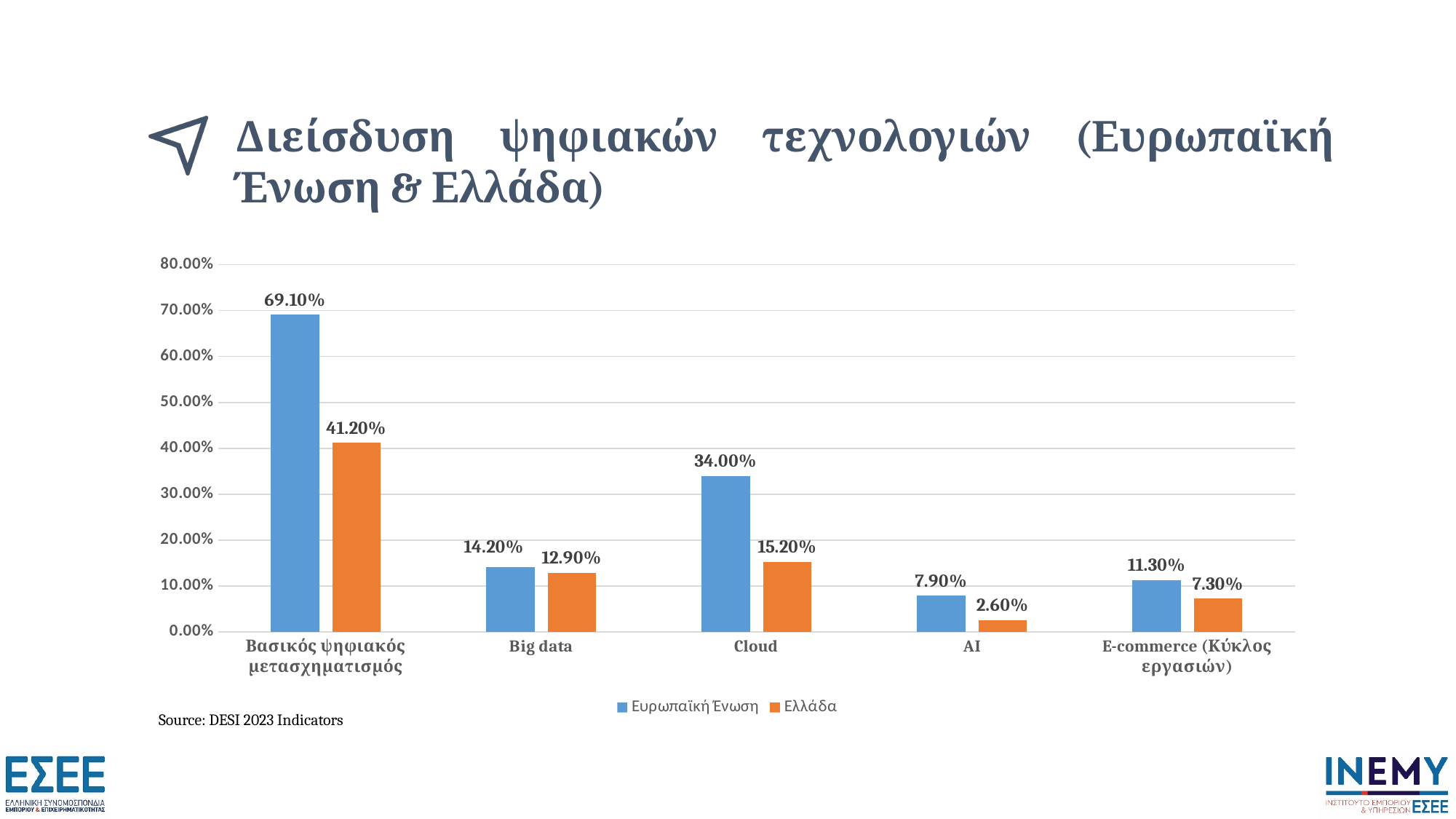
What is the difference between the Ευρωπαϊκή Ένωση and Ελλάδα values in the Βασικός ψηφιακός μετασχηματισμός category? 27.90% What is the value for Ελλάδα in the AI category? 2.60% Is the Ευρωπαϊκή Ένωση value for E-commerce (Κύκλος εργασιών) greater or less than 10.00%? greater Which is larger in the Cloud category, the Ευρωπαϊκή Ένωση value or the Ελλάδα value? Ευρωπαϊκή Ένωση What is the value for Ελλάδα in the Big data category? 12.90% What is the value for Ευρωπαϊκή Ένωση in the Cloud category? 34.00% What is the source cited below the chart? DESI 2023 Indicators Which category has the lowest value for Ελλάδα? AI What kind of chart is shown on the slide? Bar chart How many categories are shown on the x axis? 5 Which category has the highest value for Ευρωπαϊκή Ένωση? Βασικός ψηφιακός μετασχηματισμός How many series does the legend list? 2